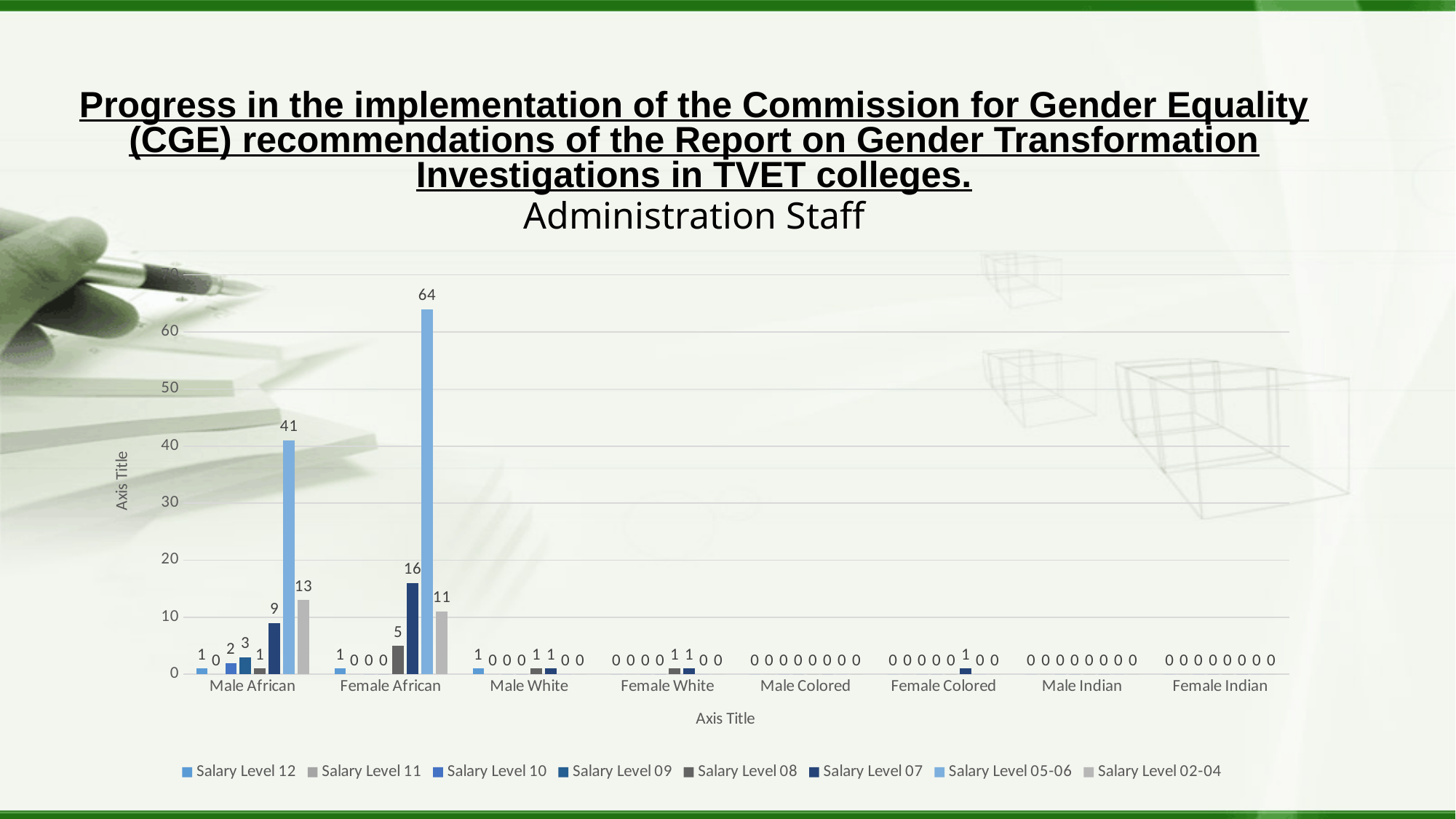
Is the value for Female African at Salary Level 05-06 greater or less than 60? greater What is the difference between the Salary Level 05-06 values for Female African and Male African? 23 What is the value for Male African at Salary Level 02-04? 13 What is the value for Male African at Salary Level 05-06? 41 Which is larger: the Salary Level 07 value for Male African or for Female African? Female African What is the value for Female African at Salary Level 05-06? 64 Which category has the highest value for Salary Level 05-06? Female African What is the title of the chart? Administration Staff What is the value for Female African at Salary Level 07? 16 How many series does the legend list? 8 How many categories are shown on the x axis? 8 What kind of chart is shown on the slide? bar chart